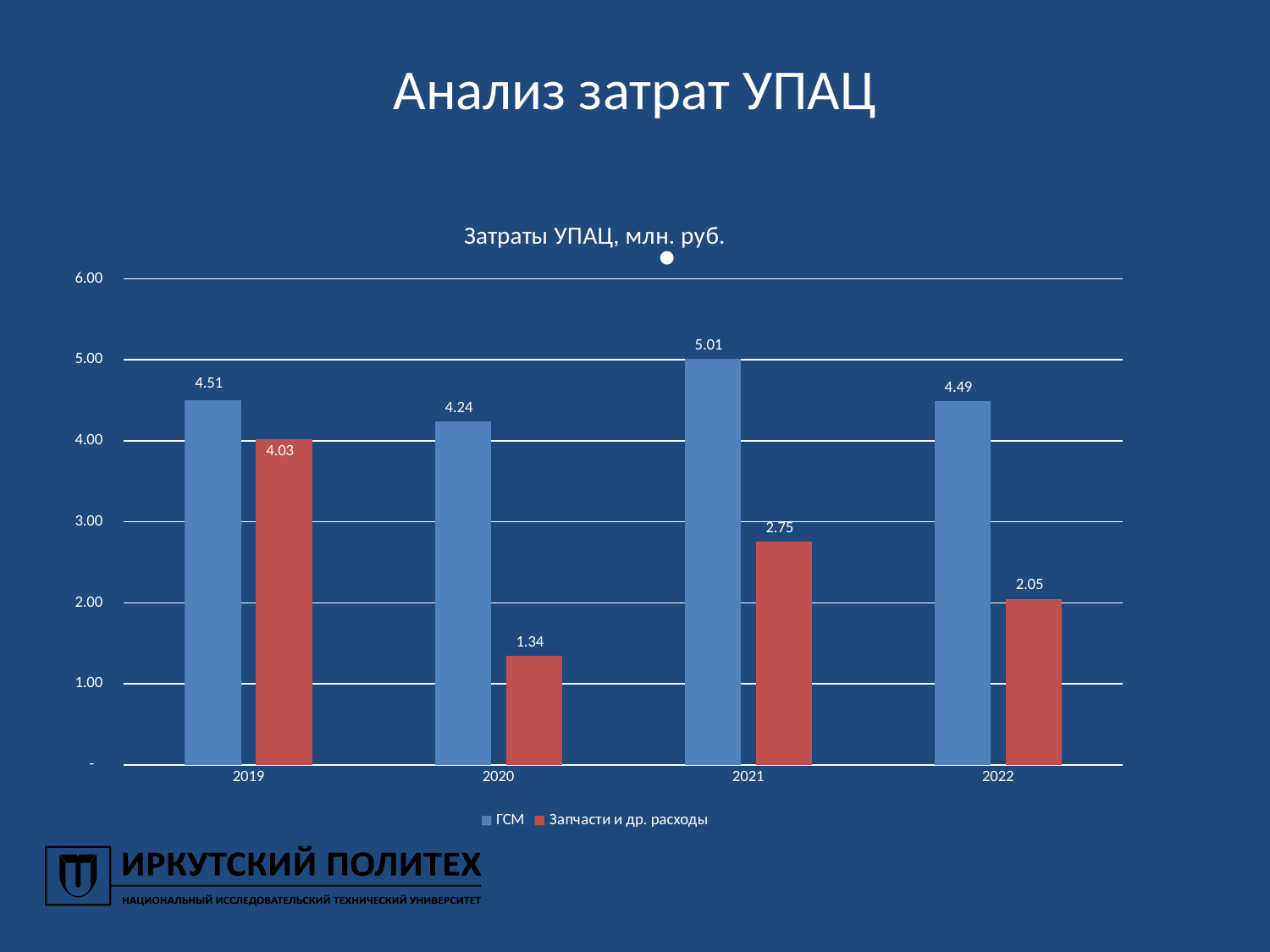
What is the title of the chart? Затраты УПАЦ, млн. руб. What is the value for Запчасти и др. расходы in 2020? 1.34 In which year is the value for Запчасти и др. расходы the lowest? 2020 What is the value for ГСМ in 2021? 5.01 In which year is the value for ГСМ the highest? 2021 Which is larger in 2019: ГСМ or Запчасти и др. расходы? ГСМ Is the value for Запчасти и др. расходы in 2021 greater or less than 3.00? less How many series does the legend list? 2 What is the value for ГСМ in 2019? 4.51 What kind of chart is shown? bar chart How many years are shown on the x axis? 4 What is the difference between ГСМ and Запчасти и др. расходы in 2022? 2.44